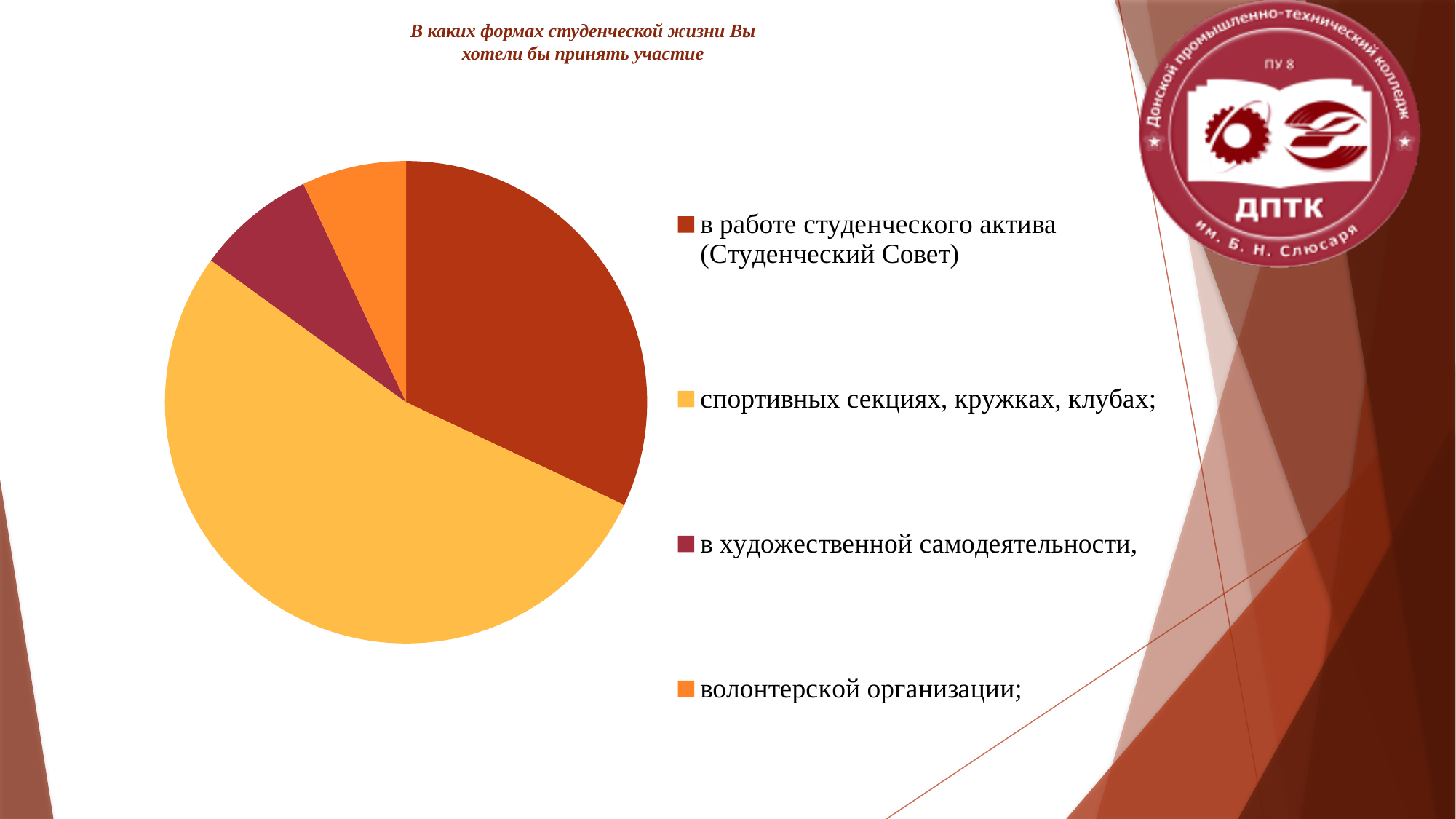
What kind of chart is shown on the slide? pie chart Which slice is larger: "в работе студенческого актива (Студенческий Совет)" or "волонтерской организации;"? в работе студенческого актива (Студенческий Совет) Which category has the largest slice of the pie chart? спортивных секциях, кружках, клубах; Which colour represents "волонтерской организации;" in the pie chart? orange What is the title of the chart on the slide? В каких формах студенческой жизни Вы хотели бы принять участие How many slices does the pie chart have? 4 Which slice is larger: "спортивных секциях, кружках, клубах;" or "в художественной самодеятельности,"? спортивных секциях, кружках, клубах; How many entries does the legend of the pie chart list? 4 Which slice is larger: "в работе студенческого актива (Студенческий Совет)" or "спортивных секциях, кружках, клубах;"? спортивных секциях, кружках, клубах;